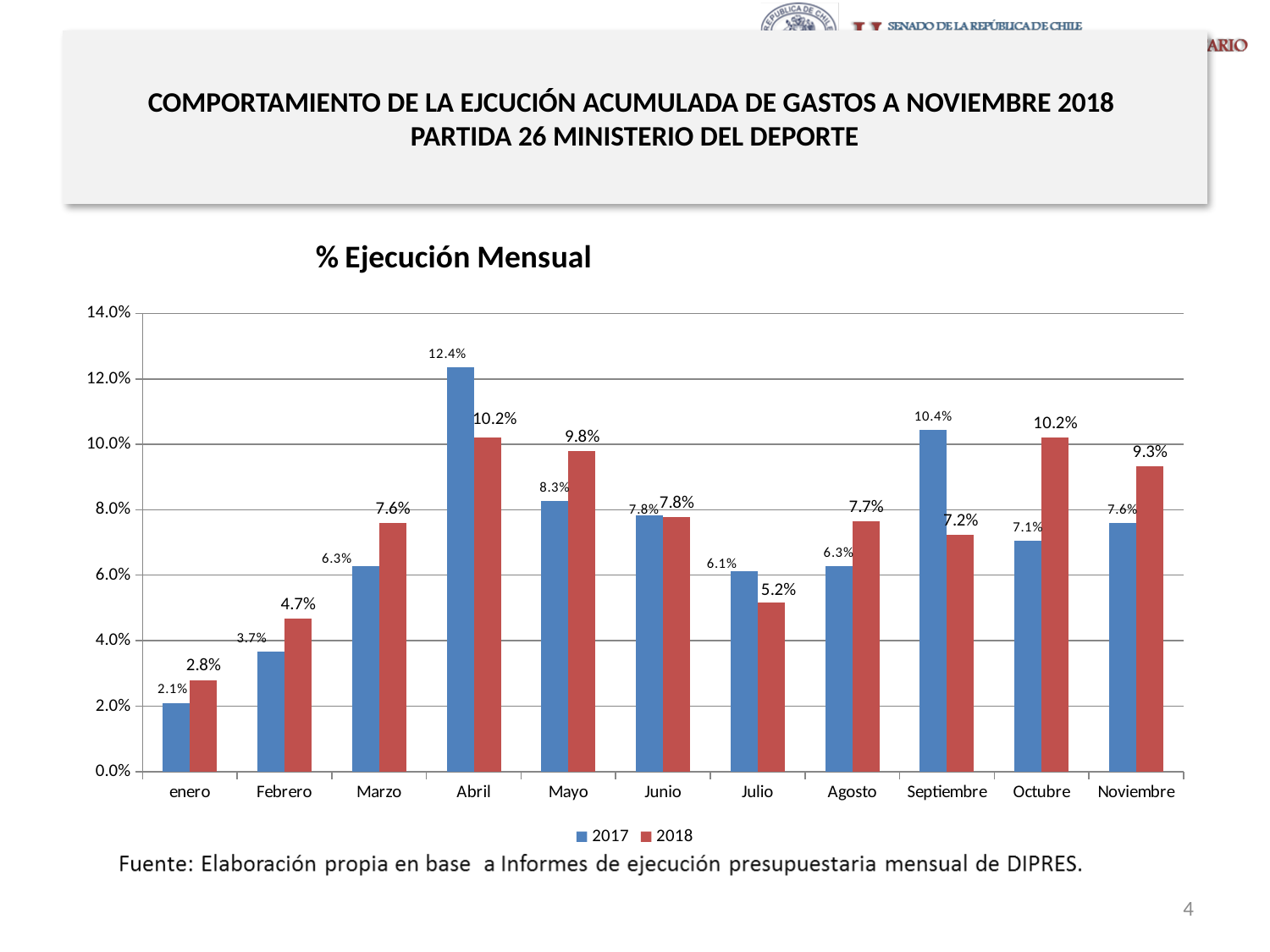
What is the value for 2018 in Julio? 5.2% What is the value for 2018 in Octubre? 10.2% Which month has the lowest value for the 2018 series? enero What is the difference between the 2017 and 2018 values in Septiembre? 3.2 percentage points What kind of chart is shown on the slide? Bar chart How many months are shown on the x axis? 11 How many series does the legend list? 2 Which is larger in Octubre, the 2017 value or the 2018 value? 2018 Which month has the highest value for the 2017 series? Abril What is the value for 2017 in Septiembre? 10.4% What is the value for 2017 in Abril? 12.4% Do the 2018 values rise or fall from enero to Abril? Rise